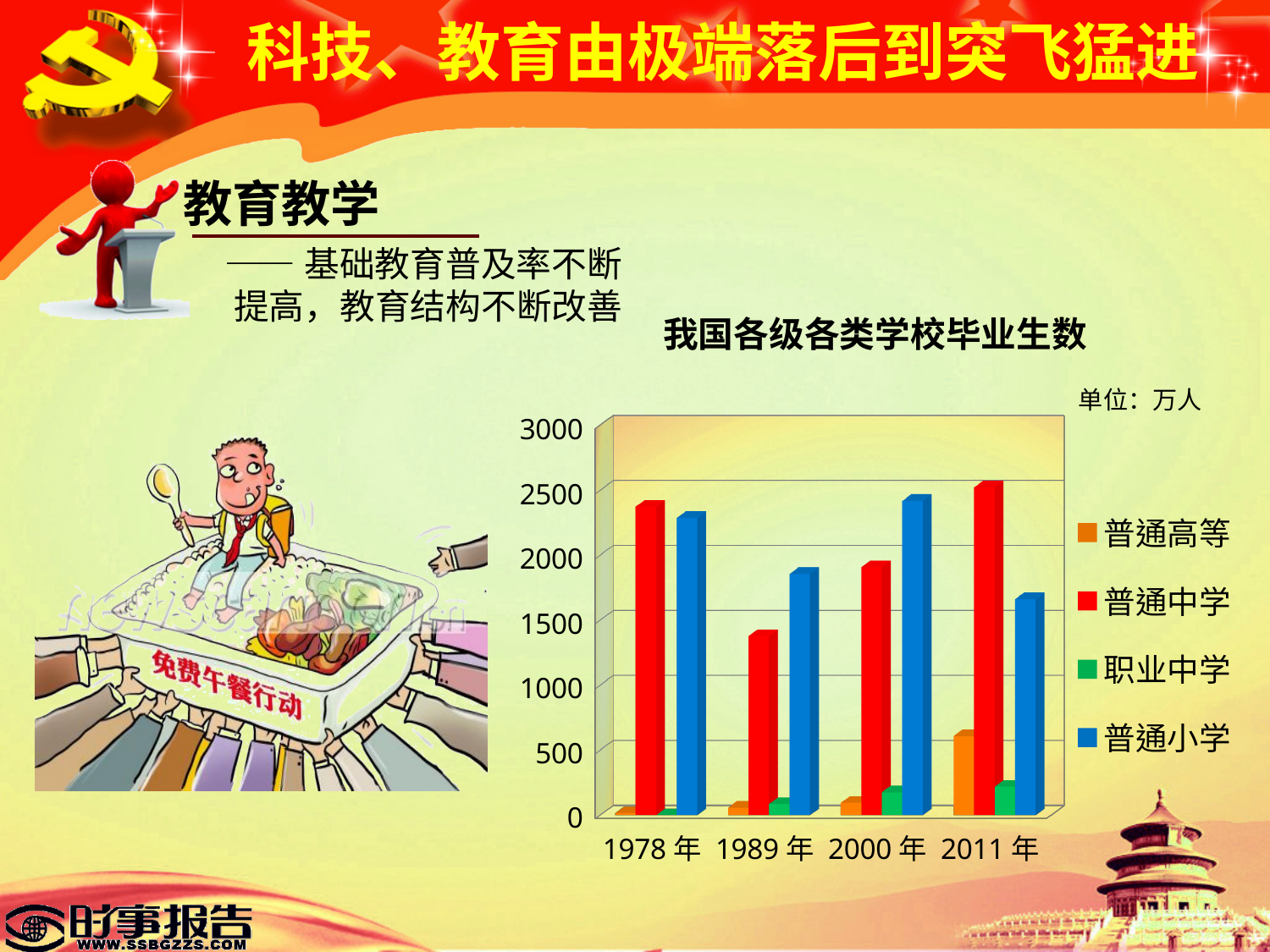
Is the value for 普通中学 in 2011年 greater or less than 2000? greater In which year is the value for 普通中学 the lowest? 1989年 How many series does the chart's legend list? 4 Is the value for 普通小学 in 2000年 greater or less than 2000? greater Is the value for 普通中学 in 1989年 greater or less than 1500? less How many year categories are shown on the x axis of the chart? 4 Which series is shown in red in the chart's legend? 普通中学 What kind of chart is shown under the title 我国各级各类学校毕业生数? bar chart In 2011年, which is larger, the value for 普通中学 or the value for 普通小学? 普通中学 What unit is stated for the values in the chart? 万人 In which year is the value for 普通高等 the highest? 2011年